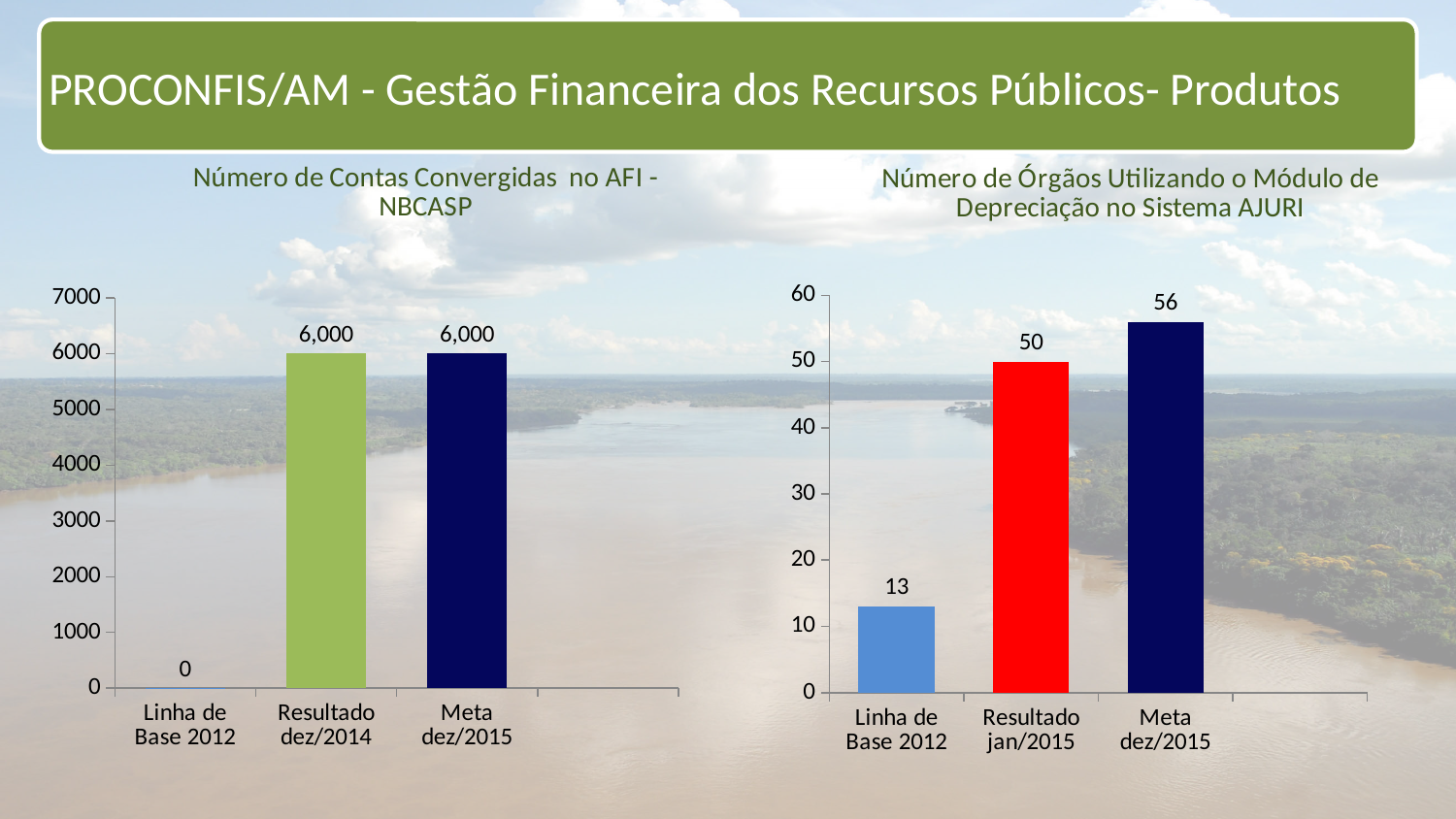
In the chart 'Número de Órgãos Utilizando o Módulo de Depreciação no Sistema AJURI', what is the value for Resultado jan/2015? 50 In the chart 'Número de Órgãos Utilizando o Módulo de Depreciação no Sistema AJURI', which category has the lowest value? Linha de Base 2012 In the chart 'Número de Contas Convergidas no AFI - NBCASP', what is the value for Linha de Base 2012? 0 In the chart 'Número de Órgãos Utilizando o Módulo de Depreciação no Sistema AJURI', what is the value for Meta dez/2015? 56 In the chart 'Número de Órgãos Utilizando o Módulo de Depreciação no Sistema AJURI', which is larger: Resultado jan/2015 or Linha de Base 2012? Resultado jan/2015 What kind of chart is the chart on the right of the slide? Bar chart In the chart 'Número de Contas Convergidas no AFI - NBCASP', what is the difference between Resultado dez/2014 and Linha de Base 2012? 6,000 In the chart 'Número de Órgãos Utilizando o Módulo de Depreciação no Sistema AJURI', which category has the highest value? Meta dez/2015 In the chart 'Número de Órgãos Utilizando o Módulo de Depreciação no Sistema AJURI', what is the difference between Meta dez/2015 and Linha de Base 2012? 43 How many categories are shown in the chart 'Número de Contas Convergidas no AFI - NBCASP'? 3 In the chart 'Número de Órgãos Utilizando o Módulo de Depreciação no Sistema AJURI', do the values rise or fall from left to right? Rise In the chart 'Número de Contas Convergidas no AFI - NBCASP', what is the value for Resultado dez/2014? 6,000